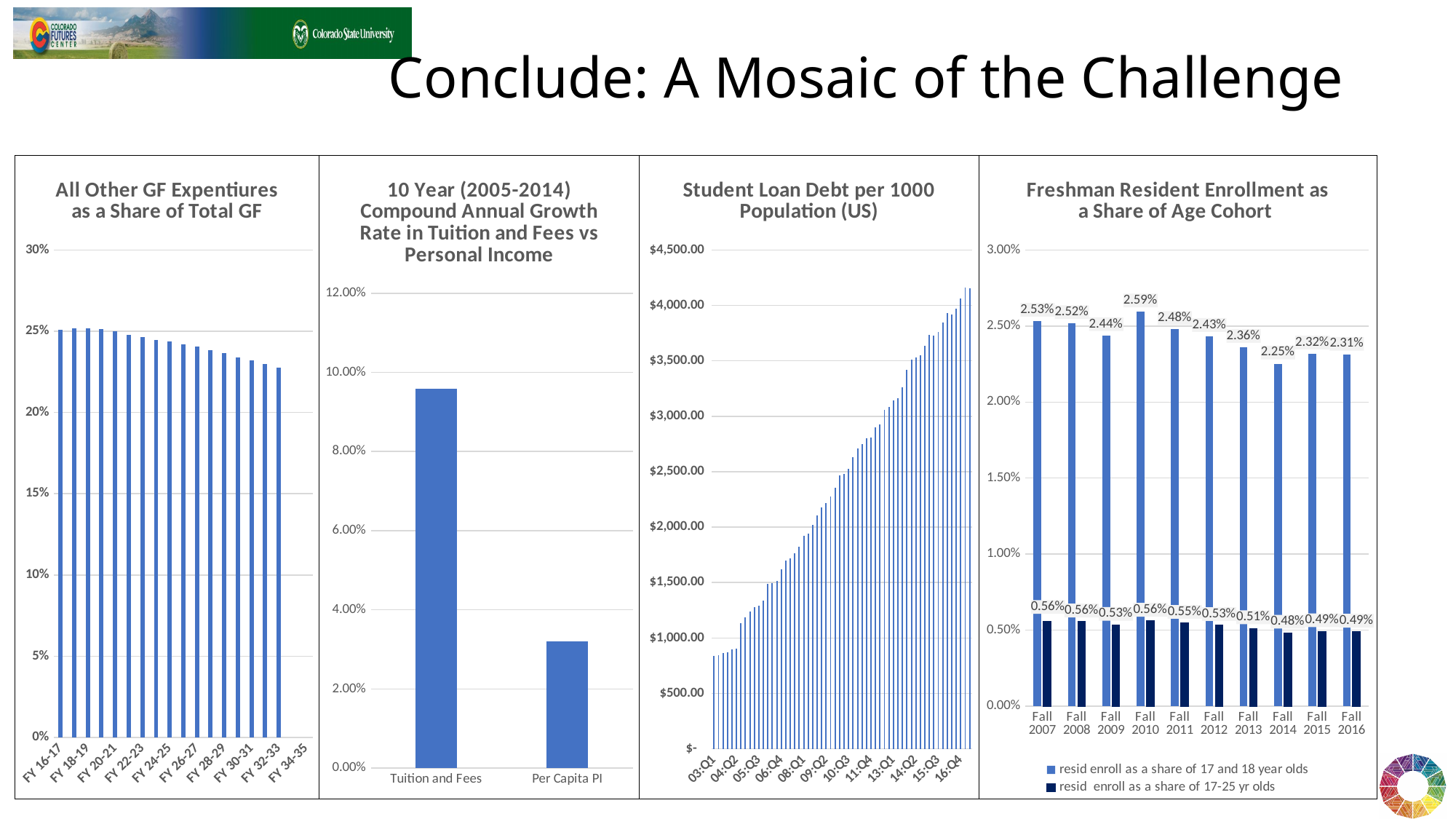
In the chart titled '10 Year (2005-2014) Compound Annual Growth Rate in Tuition and Fees vs Personal Income', which is larger, Tuition and Fees or Per Capita PI? Tuition and Fees In the chart titled 'All Other GF Expentiures as a Share of Total GF', do the values rise or fall from FY 16-17 to FY 34-35? fall In the chart titled 'Freshman Resident Enrollment as a Share of Age Cohort', what is the value for resident enrollment as a share of 17 and 18 year olds in Fall 2010? 2.59% In the chart titled 'Freshman Resident Enrollment as a Share of Age Cohort', how many years are shown on the x axis? 10 In the chart titled 'Freshman Resident Enrollment as a Share of Age Cohort', how many series does the legend list? 2 In the chart titled 'Student Loan Debt per 1000 Population (US)', do the values rise or fall along the x axis? rise In the chart titled 'Freshman Resident Enrollment as a Share of Age Cohort', what is the value for resident enrollment as a share of 17-25 yr olds in Fall 2014? 0.48% In the chart titled 'Freshman Resident Enrollment as a Share of Age Cohort', which year has the lowest value for resident enrollment as a share of 17 and 18 year olds? Fall 2014 What kind of chart is the chart titled 'All Other GF Expentiures as a Share of Total GF'? bar chart In the chart titled 'Freshman Resident Enrollment as a Share of Age Cohort', what is the difference between the Fall 2010 and Fall 2014 values for resident enrollment as a share of 17 and 18 year olds? 0.34% In the chart titled '10 Year (2005-2014) Compound Annual Growth Rate in Tuition and Fees vs Personal Income', is the value for Per Capita PI greater or less than 4.00%? less